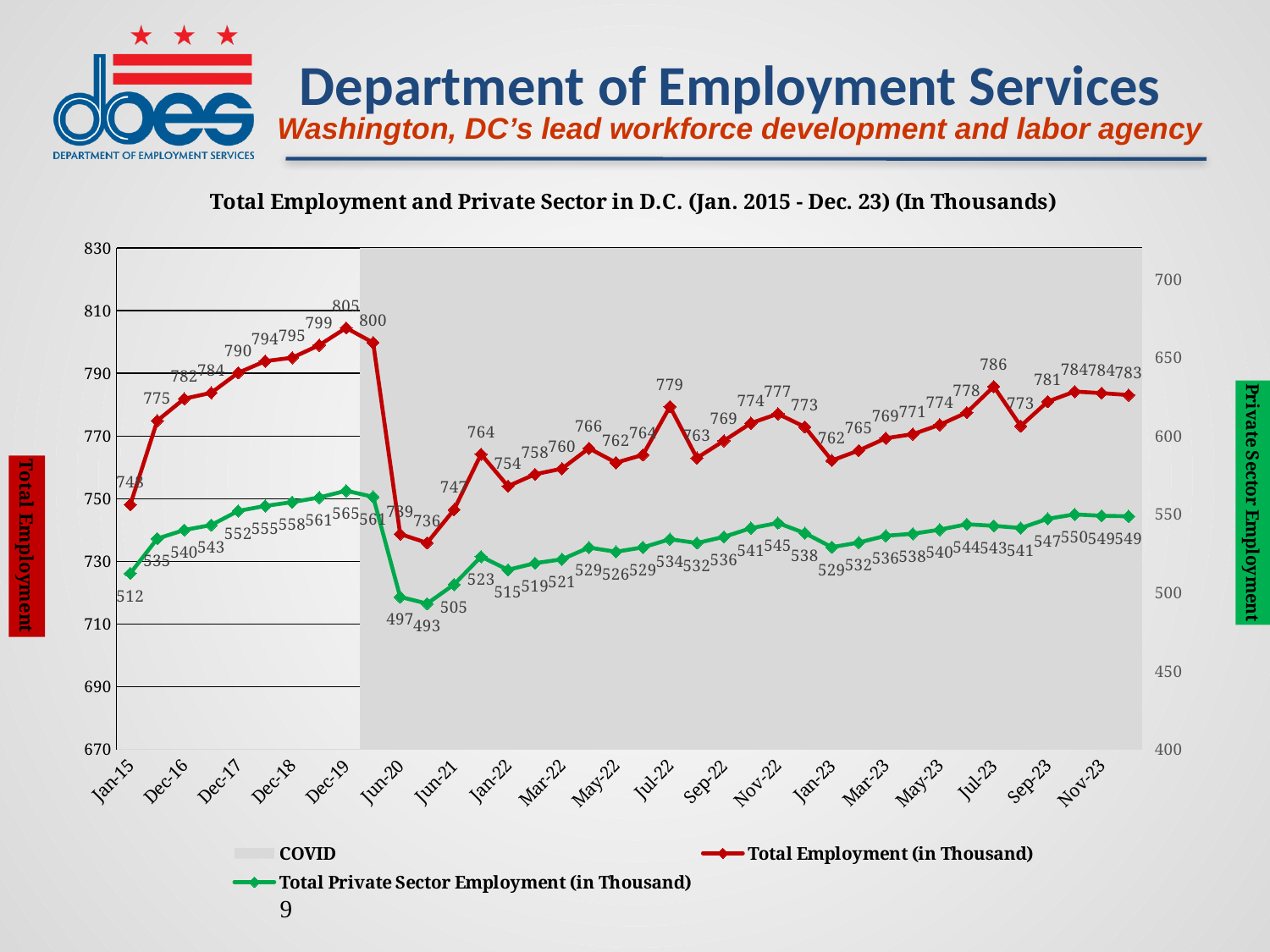
What is the Total Private Sector Employment value for Jan-15? 512 What kind of chart is shown on the slide? line chart At which x-axis label does Total Employment reach its highest value? Dec-19 Does Total Employment rise or fall from Jan-15 to Dec-19? rise What is the Total Employment value for Dec-19? 805 How many entries does the chart legend list? 3 What is the difference between Total Employment at Dec-19 and at Jun-20? 66 What is the title of the chart? Total Employment and Private Sector in D.C. (Jan. 2015 - Dec. 23) (In Thousands) What is the Total Employment value for Nov-23? 784 Which is larger, Total Employment at Jul-22 or at Jul-23? Jul-23 What is the lowest value shown for Total Private Sector Employment? 493 What is the Total Private Sector Employment value for Jun-20? 497